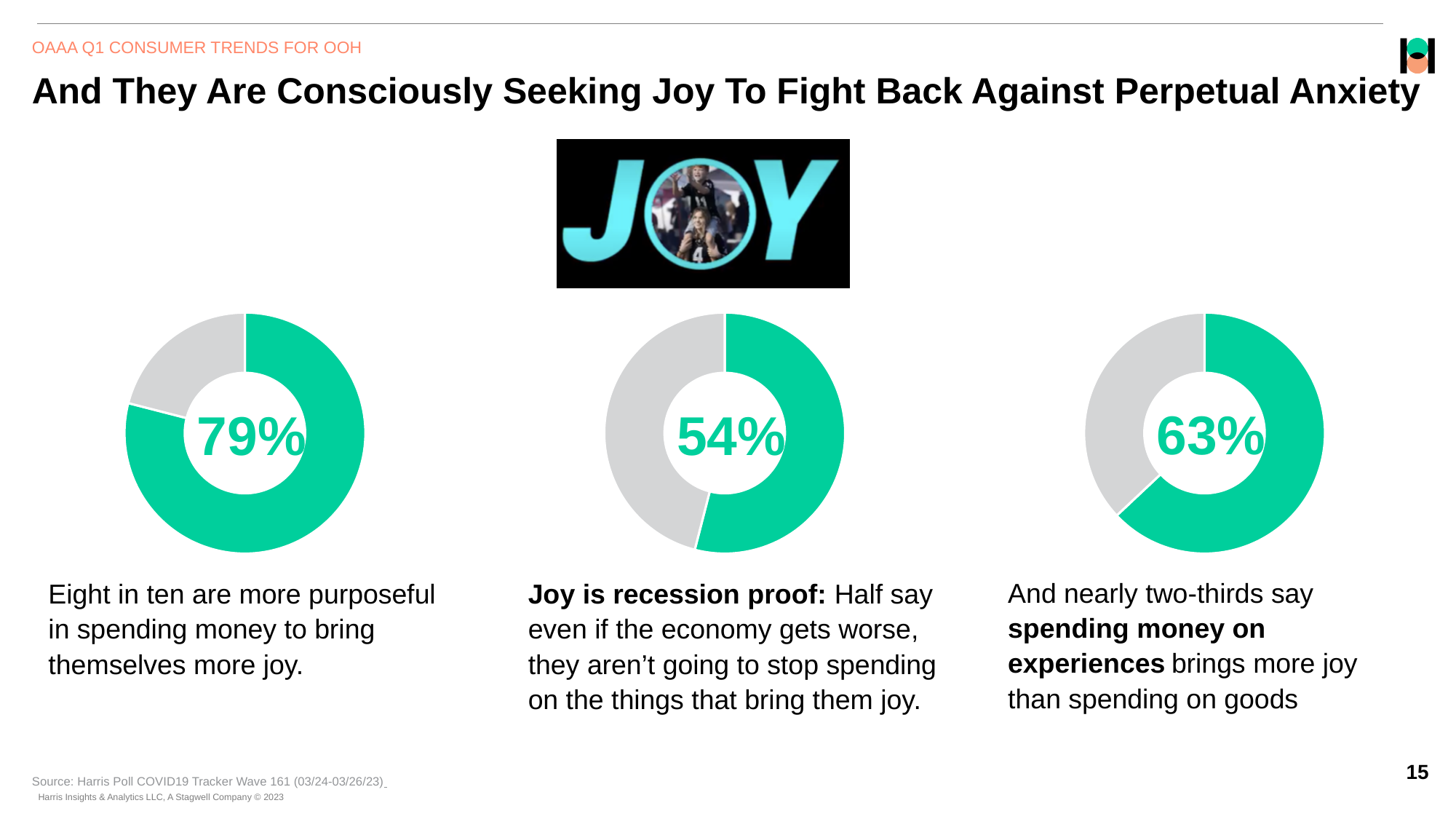
Is the percentage in the right donut chart larger or smaller than the percentage in the left donut chart? Smaller What percentage is shown in the middle donut chart about joy being recession proof? 54% Which of the three donut charts shows the lowest percentage? The middle chart (54%) What percentage is shown in the right donut chart about spending money on experiences? 63% Which of the three donut charts shows the highest percentage? The left chart (79%) What percentage is shown in the left donut chart about spending money to bring more joy? 79% What is the source cited for the data on the slide? Harris Poll COVID19 Tracker Wave 161 (03/24-03/26/23) What kind of chart is used to display the three percentages on the slide? Donut (pie) chart How many donut charts are on the slide? 3 What is the difference between the percentage in the left donut chart and the percentage in the middle donut chart? 25 percentage points What is the difference between the percentage in the right donut chart and the percentage in the middle donut chart? 9 percentage points What colour is used for the highlighted (filled) portion of each donut chart? Green